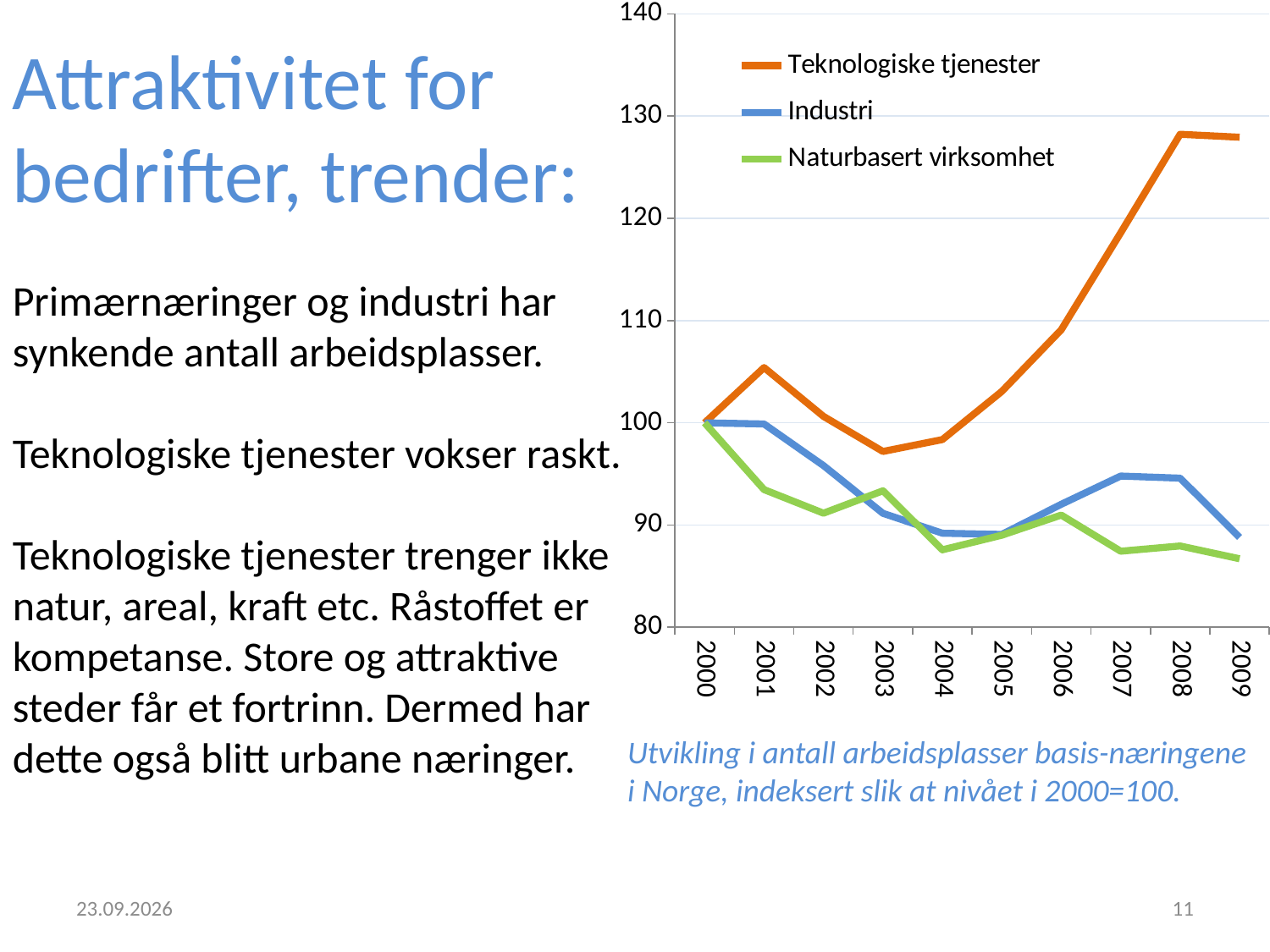
Which series has the lowest value in 2001? Naturbasert virksomhet Which series has the highest value in 2009? Teknologiske tjenester Is the value for Teknologiske tjenester in 2008 greater or less than 120? greater What type of chart is shown on the slide? Line chart How many years are shown on the x axis of the chart? 10 Does the Teknologiske tjenester line rise or fall from 2003 to 2008? Rise How many series does the chart legend list? 3 Is the value for Naturbasert virksomhet in 2004 greater or less than 90? less What colour is the Industri line in the chart? Blue Is the value for Industri in 2007 greater or less than 90? greater What is the value for Teknologiske tjenester in 2000? 100